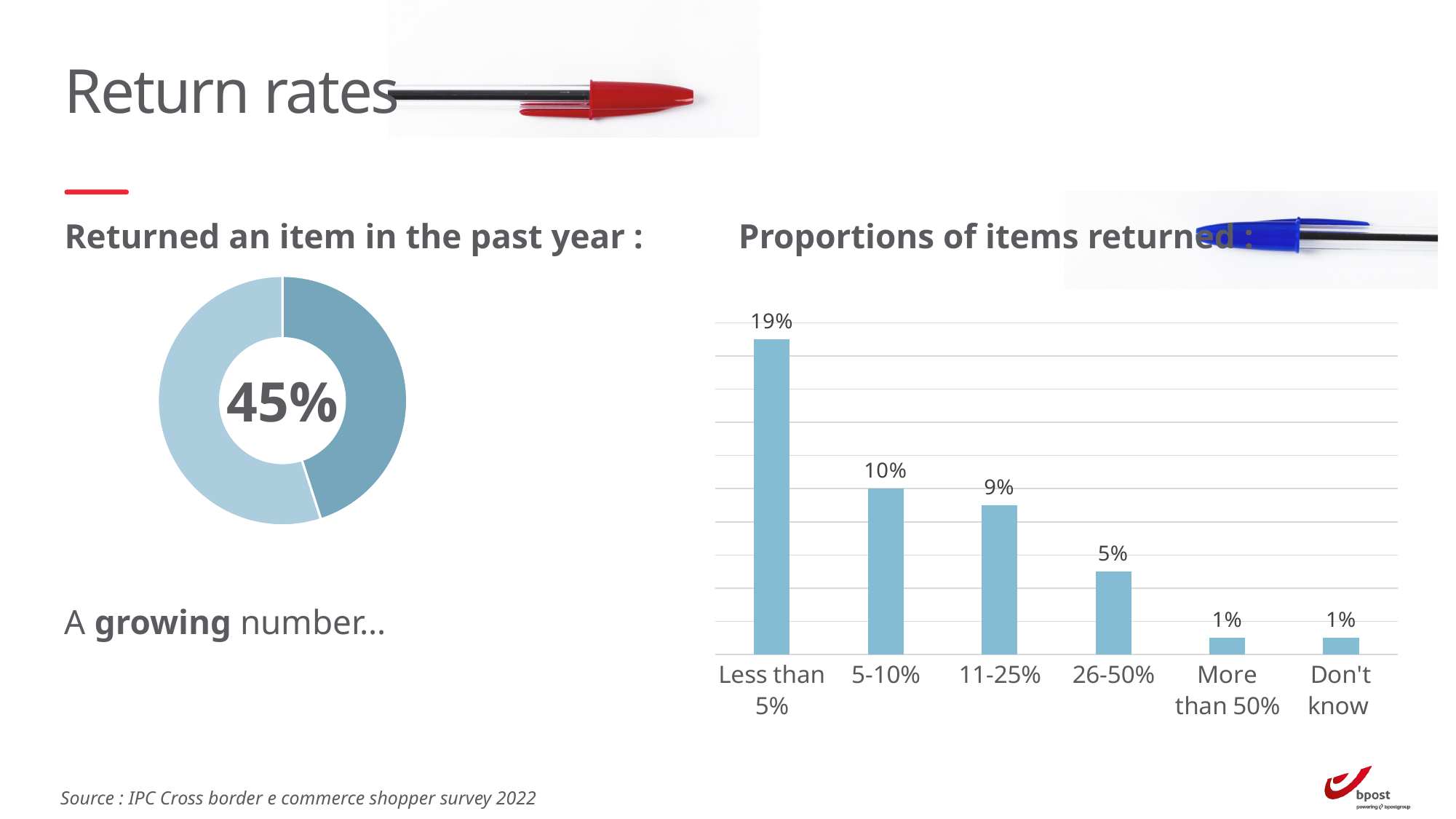
In the 'Returned an item in the past year' chart, what percentage is shown in the centre of the doughnut? 45% In the 'Proportions of items returned' chart, which category has the highest value? Less than 5% How many categories are shown in the 'Proportions of items returned' chart? 6 What kind of chart is the 'Returned an item in the past year' chart? Doughnut chart What kind of chart is the 'Proportions of items returned' chart? Bar chart In the 'Proportions of items returned' chart, what is the value for 'Less than 5%'? 19% In the 'Proportions of items returned' chart, what is the value for 'Don't know'? 1% In the 'Proportions of items returned' chart, what is the value for '26-50%'? 5% In the 'Proportions of items returned' chart, do the values rise or fall from left to right across the categories? Fall In the 'Proportions of items returned' chart, which is larger, the value for '5-10%' or the value for '11-25%'? 5-10% In the 'Proportions of items returned' chart, what is the difference between the values for 'Less than 5%' and '5-10%'? 9% In the 'Proportions of items returned' chart, what is the value for '11-25%'? 9%